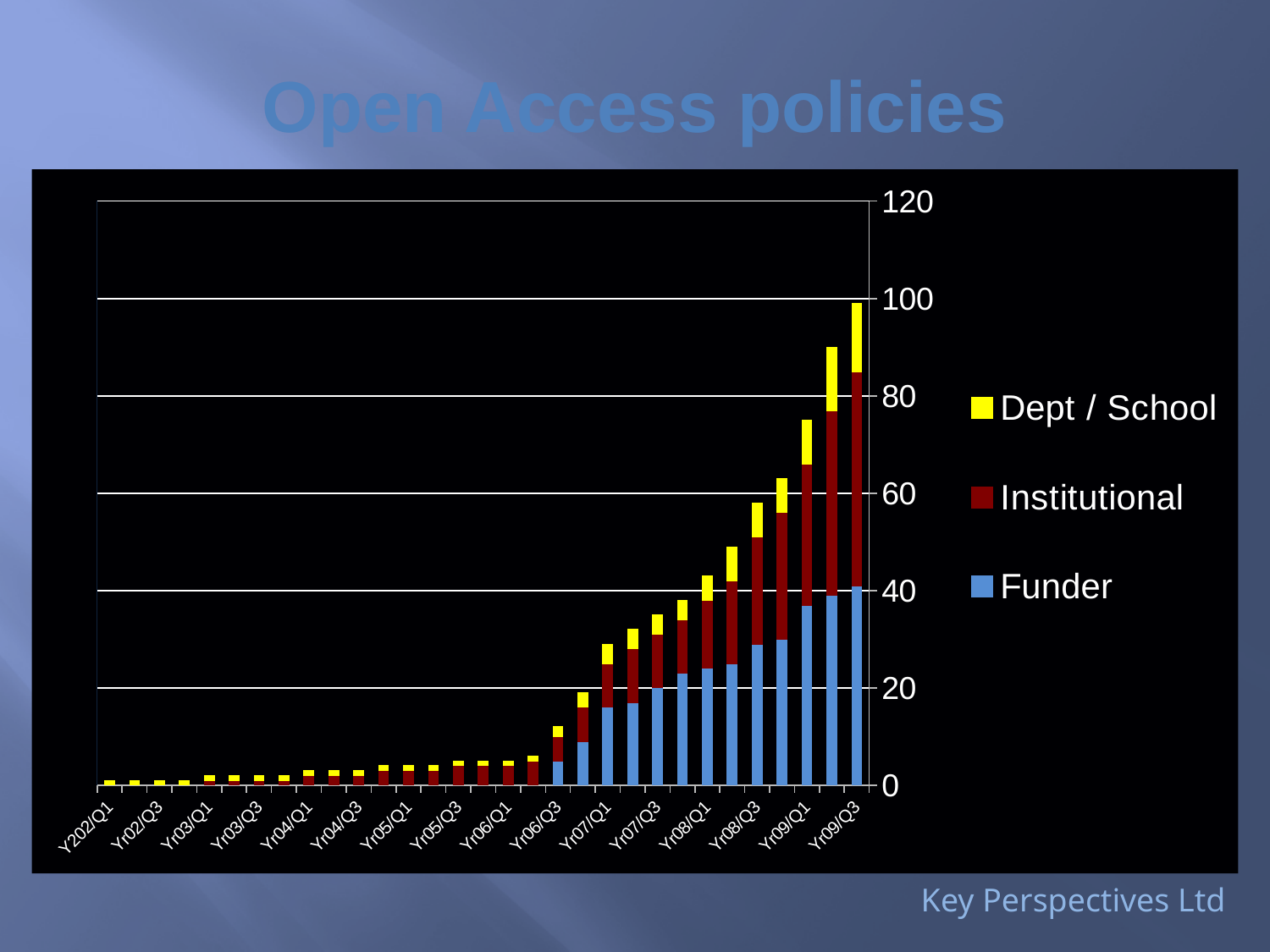
Which has the larger total bar, Yr09/Q3 or Yr08/Q1? Yr09/Q3 Is the total value for Yr09/Q3 greater or less than 80? greater Is the total value for Yr06/Q3 greater or less than 20? less Is the total value for Yr07/Q1 greater or less than 40? less How many category labels are printed along the x axis? 16 Which quarter has the tallest stacked bar? Yr09/Q3 What kind of chart is shown on the slide? stacked bar chart How many series does the legend list? 3 Which series is shown in yellow in the legend? Dept / School Do the total bar heights generally rise or fall from Y202/Q1 to Yr09/Q3? rise What is the title of the slide containing the chart? Open Access policies